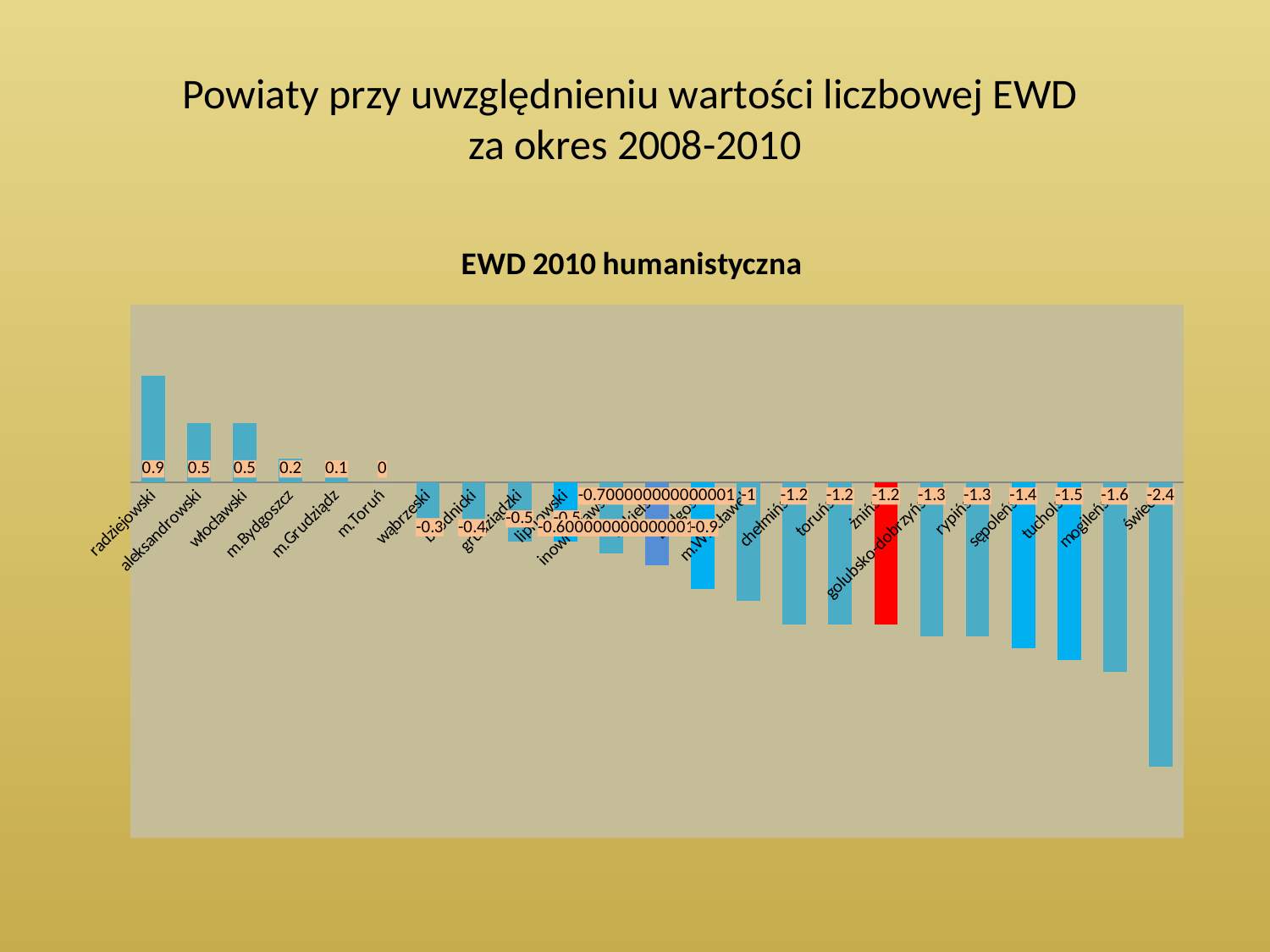
Which powiat has the lowest EWD value in the chart? świecki Which has the higher EWD value, radziejowski or włocławski? radziejowski What is the EWD value for radziejowski? 0.9 Do the values rise or fall moving from left to right along the x axis? fall What is the title of the chart? EWD 2010 humanistyczna Which powiat has the highest EWD value in the chart? radziejowski What is the EWD value for m.Toruń? 0 What is the EWD value for tucholski? -1.5 What is the EWD value for wąbrzeski? -0.3 What type of chart is shown on the slide? bar chart What is the difference between the values for radziejowski and aleksandrowski? 0.4 What is the difference between the values for mogileński and świecki? 0.8